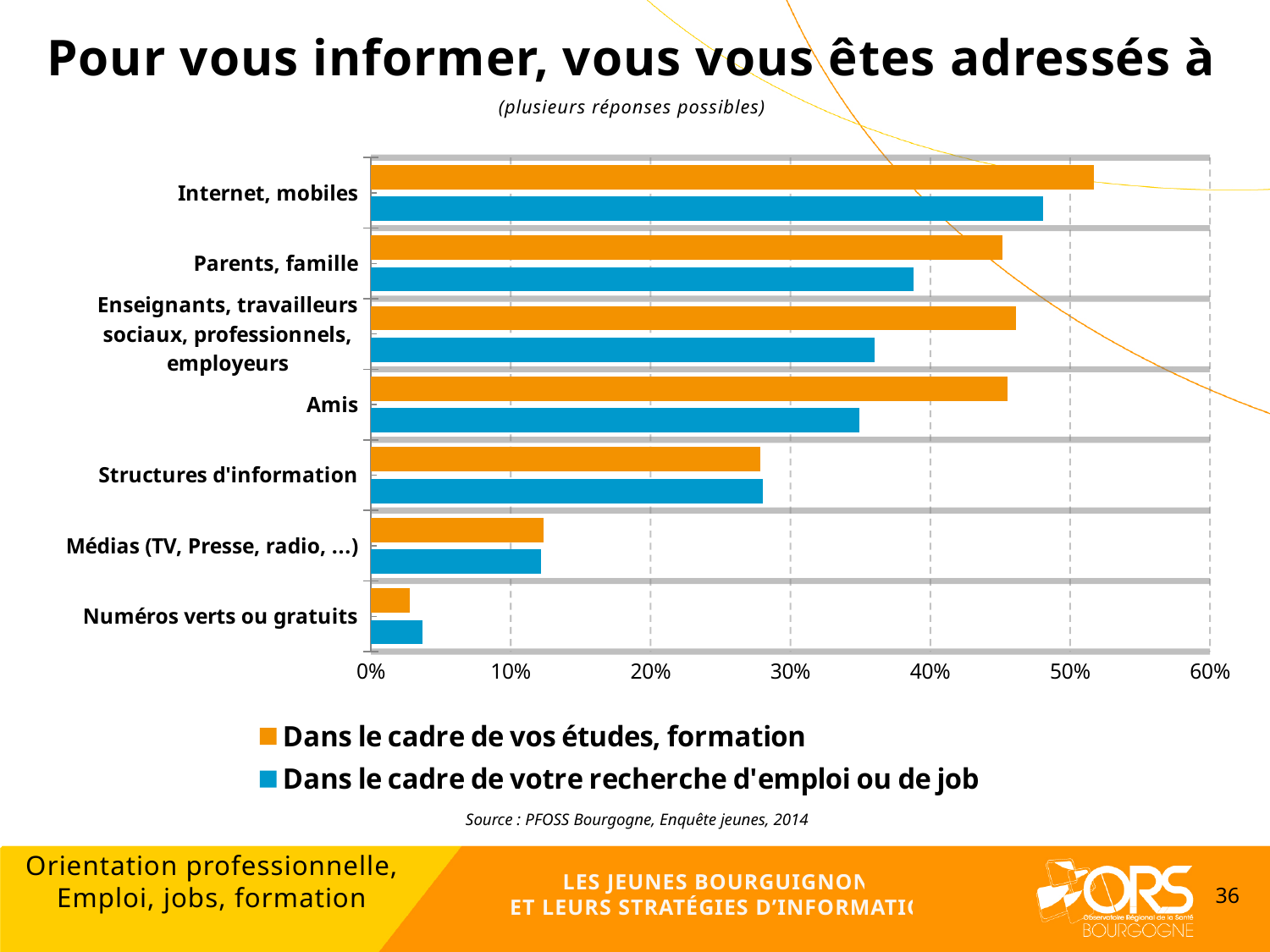
What kind of chart is shown on the slide? bar chart Which category has the highest value for the series 'Dans le cadre de vos études, formation'? Internet, mobiles For the series 'Dans le cadre de vos études, formation', which is larger: 'Internet, mobiles' or 'Parents, famille'? Internet, mobiles Which colour represents the series 'Dans le cadre de votre recherche d'emploi ou de job'? blue Which category has the lowest value for the series 'Dans le cadre de votre recherche d'emploi ou de job'? Numéros verts ou gratuits How many categories are shown on the chart? 7 Is the value for 'Numéros verts ou gratuits' in the series 'Dans le cadre de votre recherche d'emploi ou de job' greater or less than 10%? less How many series does the legend list? 2 Is the value for 'Structures d'information' in the series 'Dans le cadre de vos études, formation' greater or less than 30%? less Is the value for 'Internet, mobiles' in the series 'Dans le cadre de votre recherche d'emploi ou de job' greater or less than 50%? less